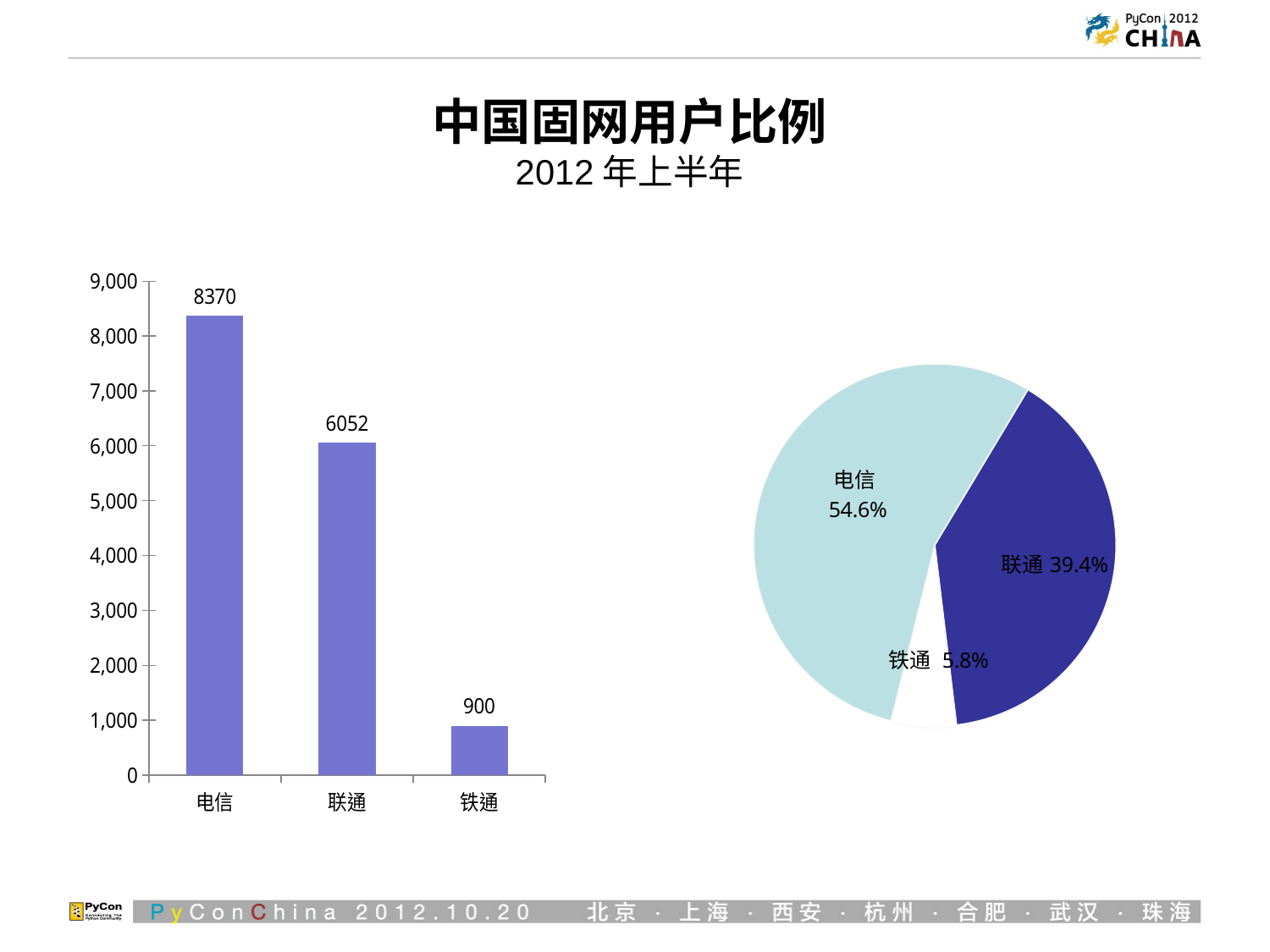
In the bar chart on the left, which category has the lowest value? 铁通 In the bar chart on the left, what is the value for 电信? 8370 In the bar chart on the left, what is the difference between the values for 电信 and 联通? 2318 In the bar chart on the left, which category has the highest value? 电信 In the pie chart on the right, what share does 电信 have? 54.6% In the bar chart on the left, how many categories are shown? 3 In the bar chart on the left, which is larger, the value for 联通 or the value for 铁通? 联通 In the bar chart on the left, what is the value for 联通? 6052 In the bar chart on the left, what is the value for 铁通? 900 What kind of chart is on the left side of the slide? bar chart What kind of chart is on the right side of the slide? pie chart In the pie chart on the right, what share does 铁通 have? 5.8%